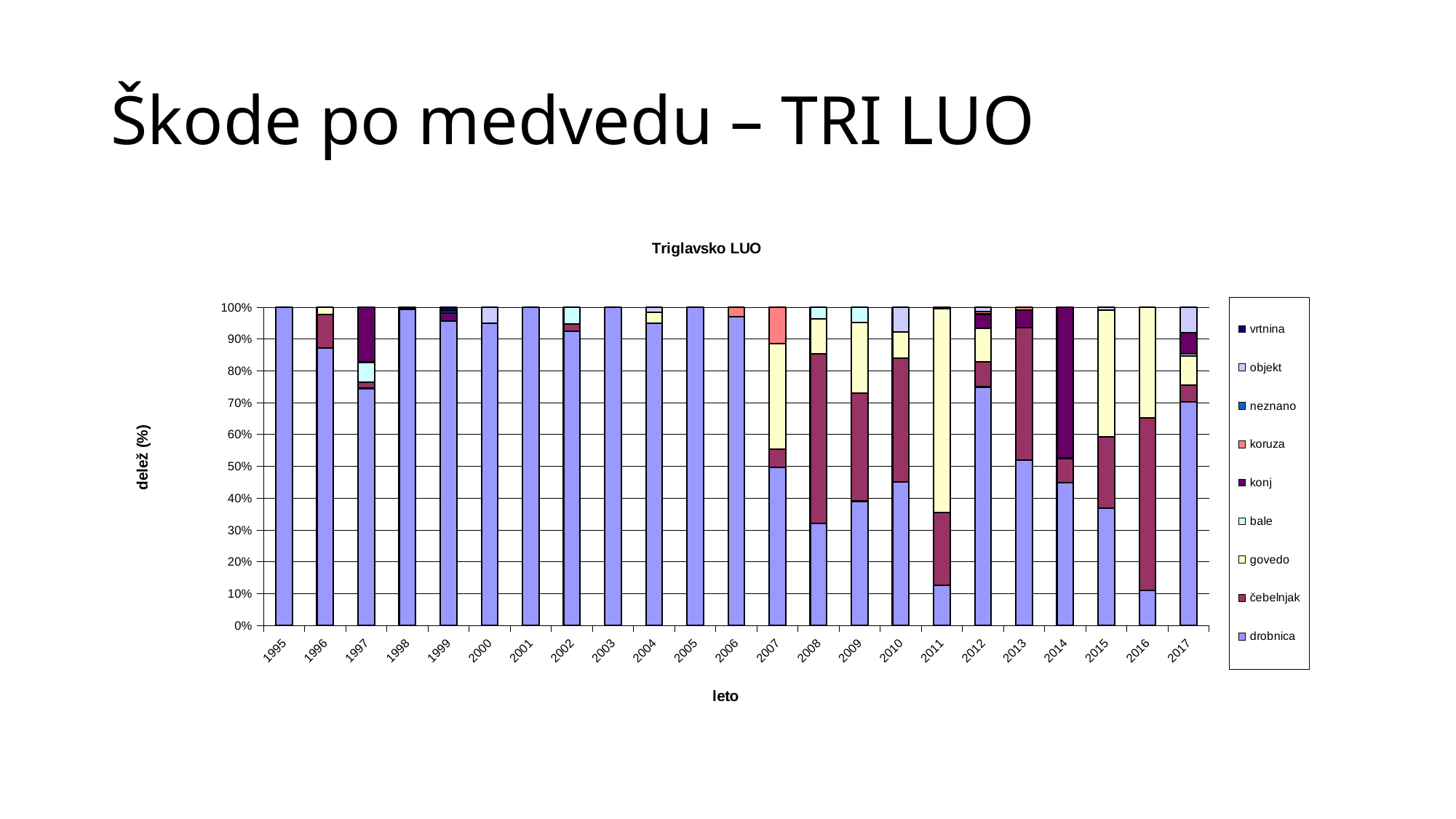
How many series does the legend list? 9 Is the drobnica share in 2017 greater or less than 60%? greater How many years are shown on the x axis? 23 Which year has the largest konj share? 2014 What kind of chart is shown on the slide? Stacked bar chart What is the label of the y axis? delež (%) Which year has the larger drobnica share, 2011 or 2012? 2012 Is the drobnica share in 2012 greater or less than 70%? greater Is the drobnica share in 2008 greater or less than 40%? less What is the title of the chart? Triglavsko LUO Which year has the largest govedo share? 2011